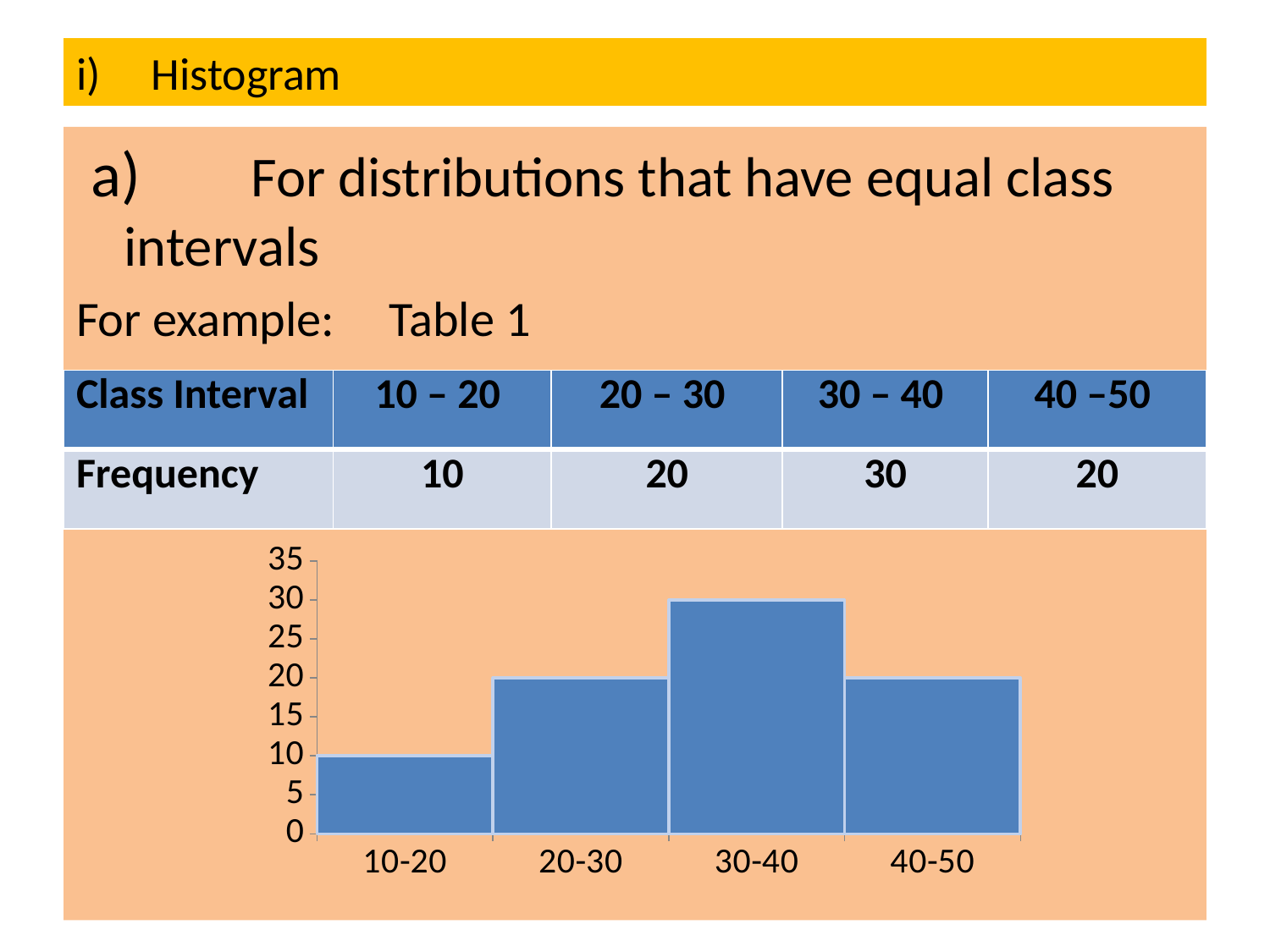
What is the frequency for the 20-30 class interval in the chart? 20 What is the highest value shown on the vertical axis of the chart? 35 What is the frequency for the 30-40 class interval in the chart? 30 How many class intervals are plotted in the chart? 4 Which class interval has the highest frequency in the chart? 30-40 What kind of chart is shown on the slide? bar chart (histogram) Is the frequency for the 40-50 interval greater or less than 25? less What is the difference between the frequency of the 30-40 interval and the 10-20 interval? 20 Which has a larger frequency, the 20-30 interval or the 30-40 interval? 30-40 Which class interval has the lowest frequency in the chart? 10-20 Do the frequencies rise or fall from the 10-20 interval to the 30-40 interval? rise What is the frequency for the 10-20 class interval in the chart? 10